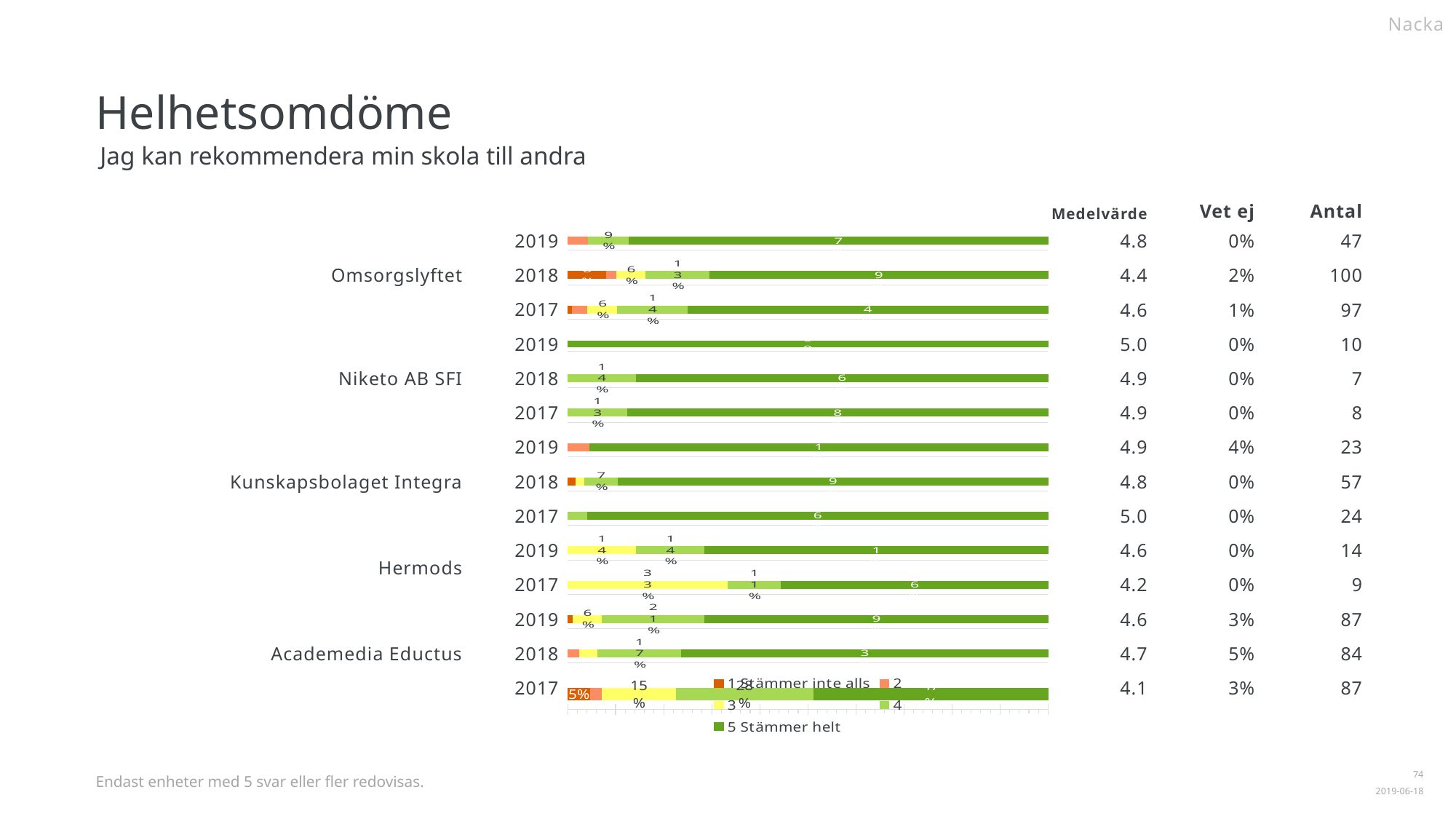
What is the Antal for Omsorgslyftet in 2018? 100 How many series does the chart legend list? 5 Which has the higher Medelvärde, Hermods 2019 or Hermods 2017? Hermods 2019 How many bars (school-year rows) are plotted in the chart? 14 What share of Academedia Eductus 2017 responses is '1 Stämmer inte alls'? 5% What is the Medelvärde for Niketo AB SFI in 2019? 5.0 Which row has the lowest Medelvärde? Academedia Eductus 2017 What is the difference in Antal between Omsorgslyftet 2017 and Omsorgslyftet 2019? 50 What is the Vet ej value for Kunskapsbolaget Integra in 2019? 4% What kind of chart is shown on the slide? bar chart Which row has the highest Antal? Omsorgslyftet 2018 What is the Vet ej value for Academedia Eductus in 2018? 5%